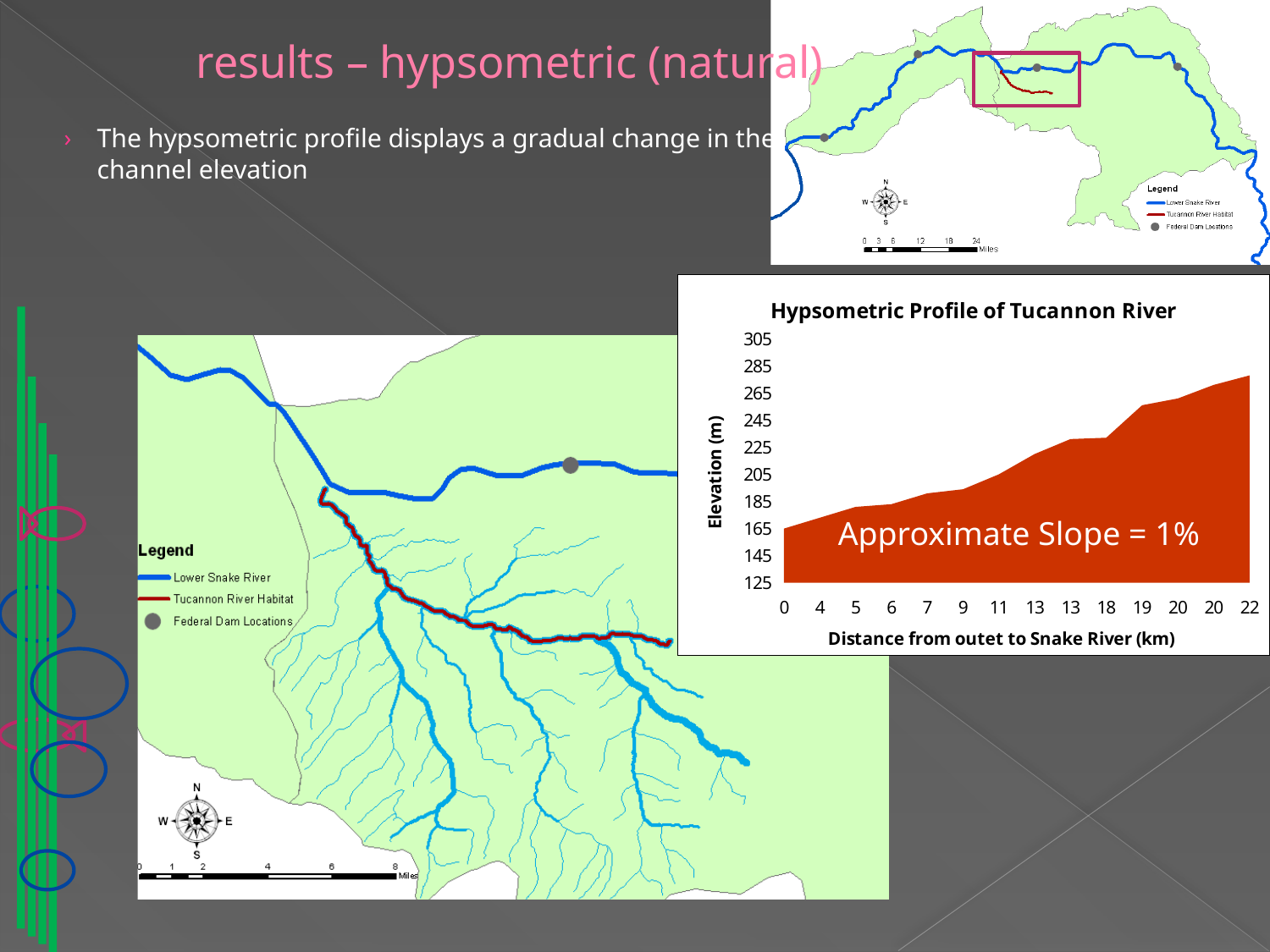
Is the elevation at 7 km greater or less than 165? greater What is the title of the chart on the slide? Hypsometric Profile of Tucannon River Do the elevation values rise or fall as distance from the outlet increases along the x axis? rise What is the highest tick value shown on the y axis of the chart? 305 What is the label of the y axis of the chart? Elevation (m) How many tick labels are shown along the x axis of the chart? 14 Is the elevation at 0 km greater or less than 185? less Is the elevation at 18 km greater or less than 225? greater Which distance has the higher elevation, 0 km or 22 km? 22 km What kind of chart is the Hypsometric Profile of Tucannon River? area chart